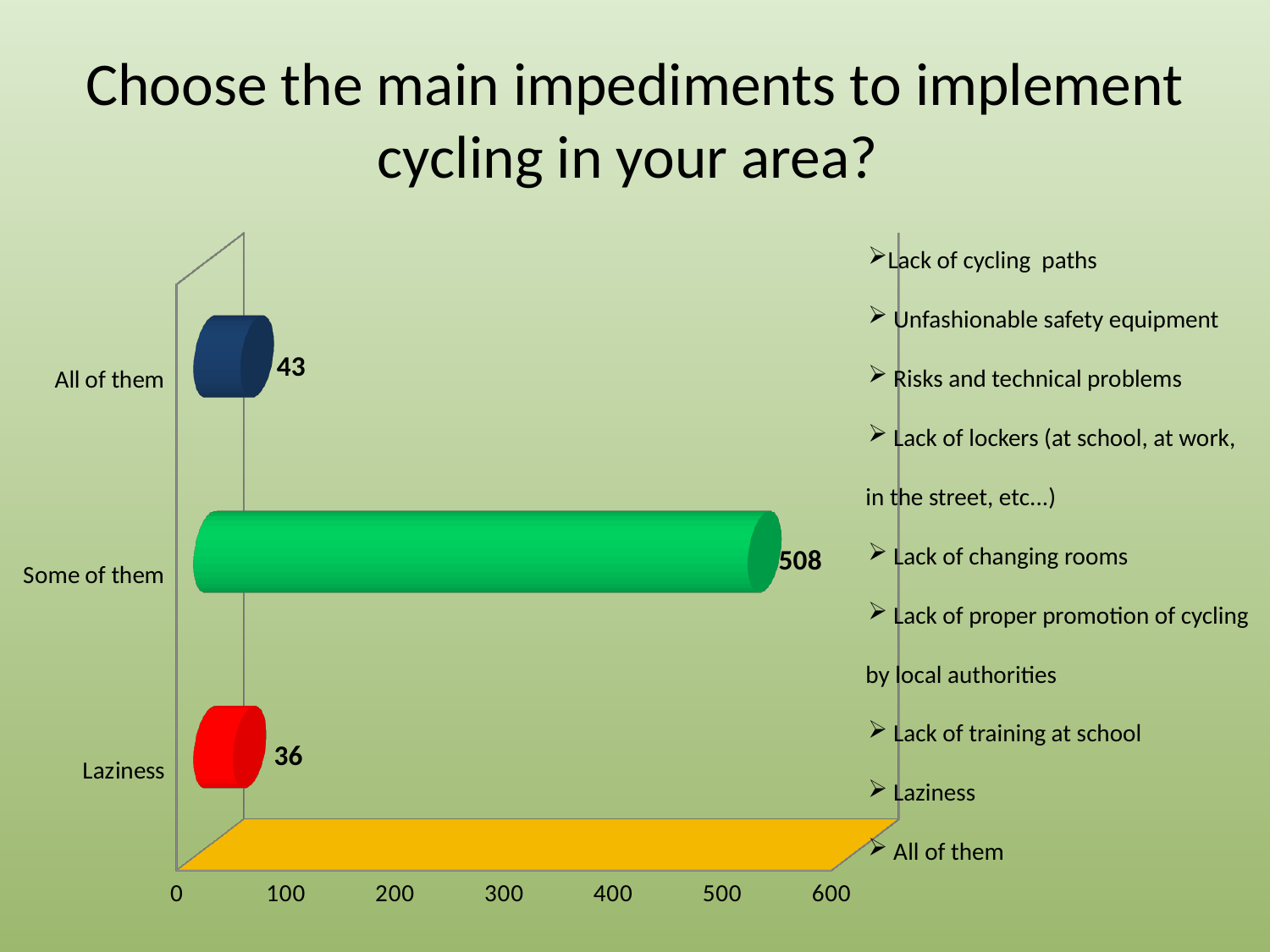
What is the difference between the values for "All of them" and "Laziness"? 7 Which is larger, the value for "All of them" or the value for "Laziness"? All of them What is the value for "Laziness"? 36 What is the value for "Some of them"? 508 What is the value for "All of them"? 43 What kind of chart is shown on the slide? bar chart What colour is the bar for "Some of them"? green Which category has the highest value? Some of them What is the difference between the values for "Some of them" and "All of them"? 465 How many categories are shown in the chart? 3 Which category has the lowest value? Laziness Is the value for "Some of them" greater or less than 500? greater